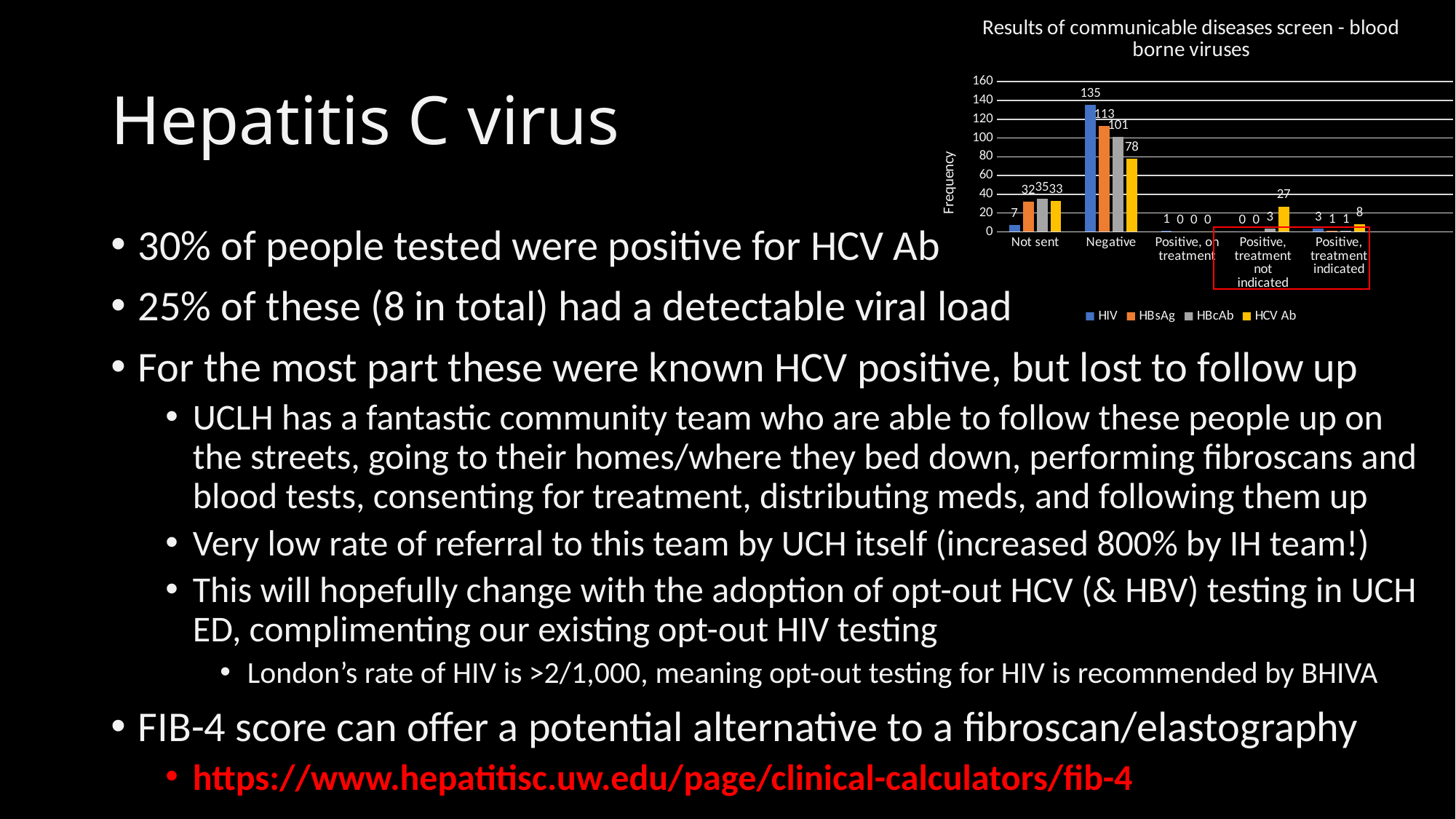
Which series has the lowest value in the Not sent category? HIV What is the difference between the HIV and HCV Ab values in the Negative category? 57 What is the title of the chart? Results of communicable diseases screen - blood borne viruses What kind of chart is shown? Bar chart How many series does the legend list? 4 Which series has the highest value in the Negative category? HIV What is the HBsAg value for the Not sent category? 32 What is the HCV Ab value for the Positive, treatment not indicated category? 27 What is the HCV Ab value for the Positive, treatment indicated category? 8 How many categories are shown on the x axis? 5 Which is larger in the Negative category, HBsAg or HBcAb? HBsAg What is the HIV value for the Negative category? 135